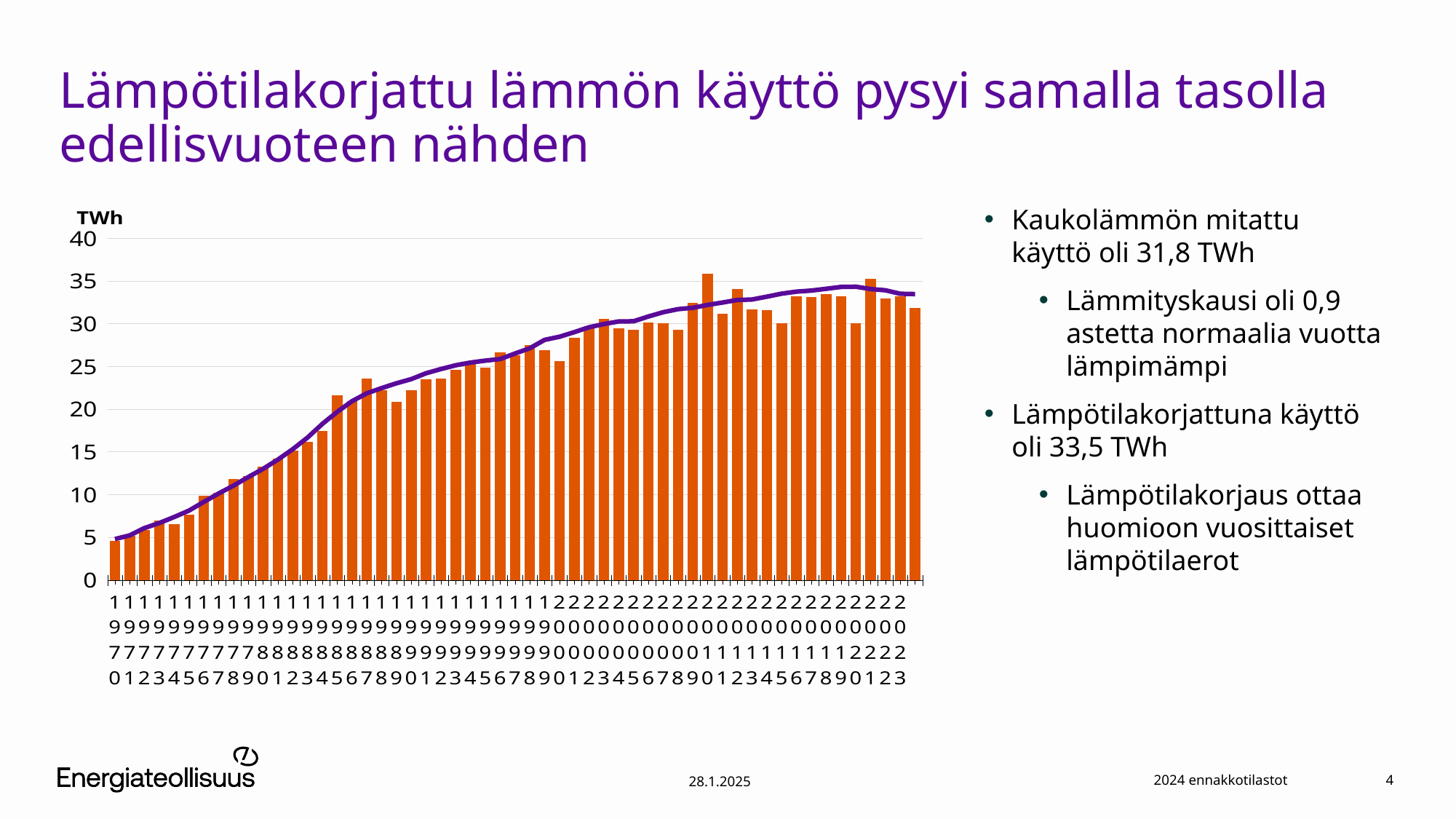
Which year has the lowest bar on the chart? 1970 What is the last year shown on the x axis of the chart? 2023 What unit is shown on the y axis of the chart? TWh What kind of chart is shown on the slide? Bar chart with a line overlay Which year has the highest bar on the chart? 2010 How many years (bars) are plotted on the chart? 55 Is the bar value for 1980 greater or less than 10? greater Which year has the larger bar, 1980 or 1990? 1990 What is the first year shown on the x axis of the chart? 1970 Is the bar value for 1990 greater or less than 20? greater Is the bar value for 1975 greater or less than 10? less